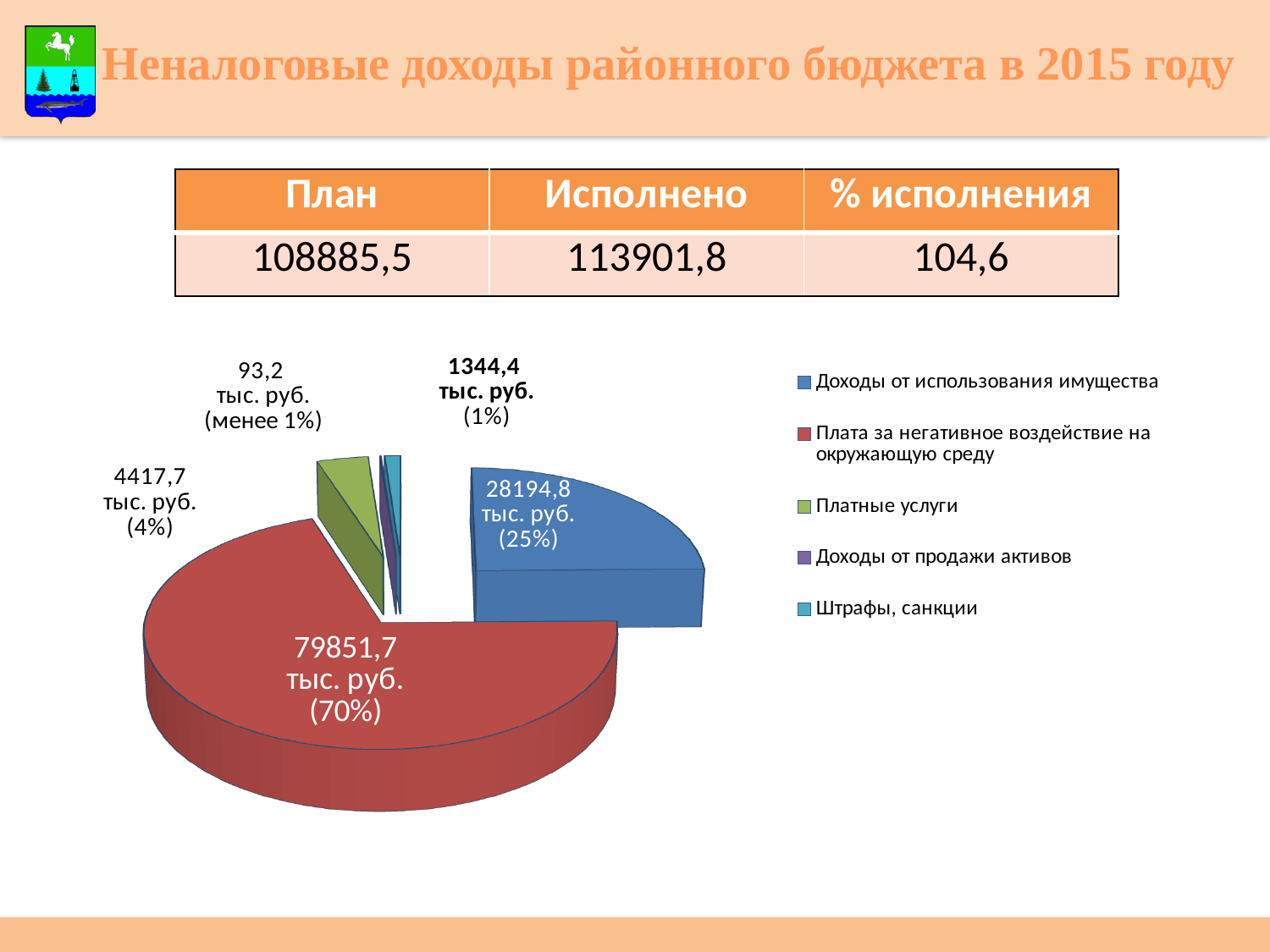
Which category has the largest slice in the pie chart? Плата за негативное воздействие на окружающую среду Which category has the smallest slice in the pie chart? Доходы от продажи активов What share of the pie does Плата за негативное воздействие на окружающую среду represent? 70% What is the value for Платные услуги in the pie chart? 4417,7 тыс. руб. What share of the pie does Доходы от использования имущества represent? 25% What is the value for Доходы от использования имущества in the pie chart? 28194,8 тыс. руб. What is the value for Плата за негативное воздействие на окружающую среду in the pie chart? 79851,7 тыс. руб. What kind of chart is shown on the slide? pie chart What is the value for Штрафы, санкции in the pie chart? 1344,4 тыс. руб. What colour is the slice for Платные услуги in the pie chart? green How many slices does the pie chart have? 5 Which is larger in the pie chart: Платные услуги or Штрафы, санкции? Платные услуги